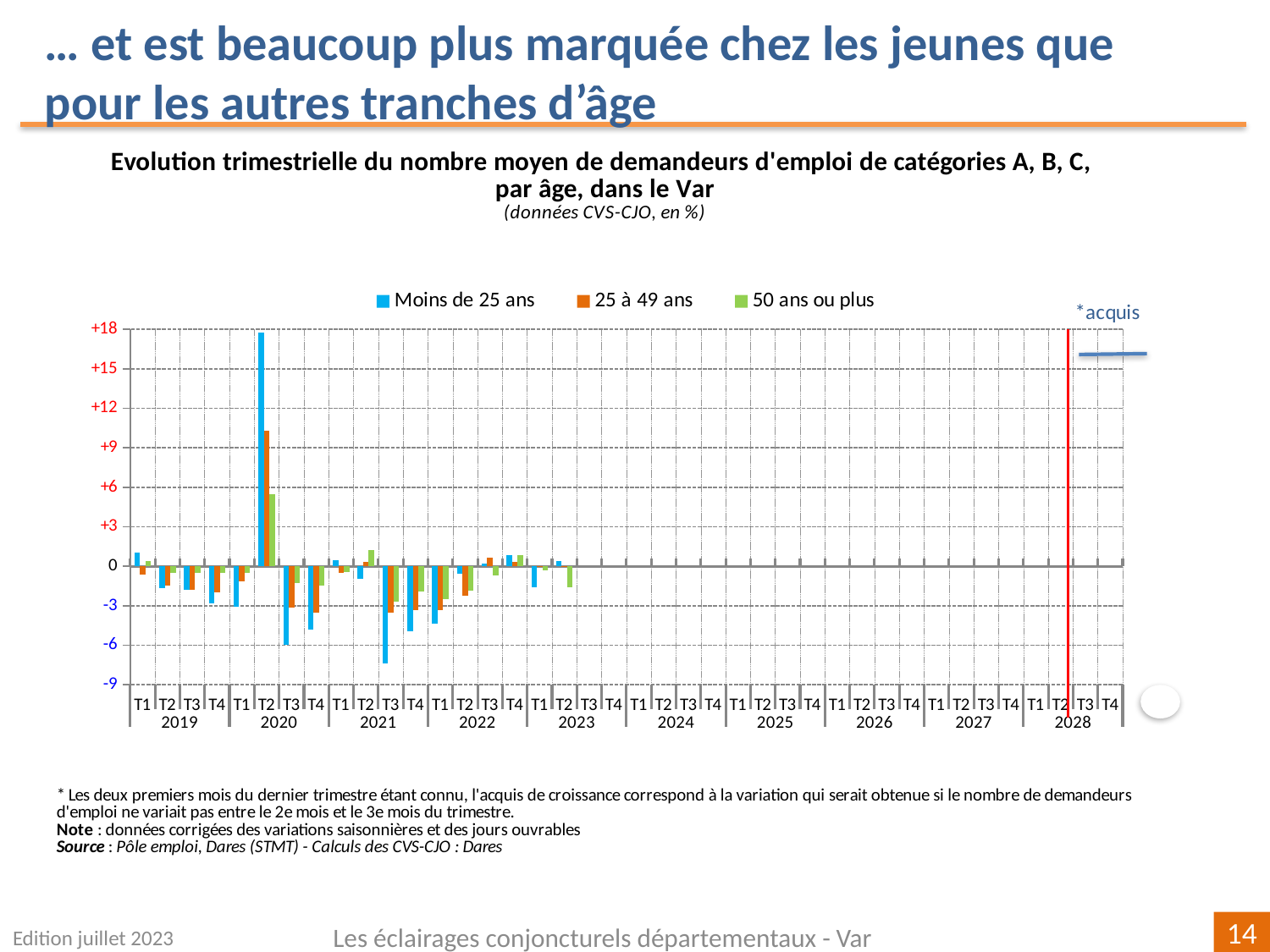
Which series is shown in blue in the legend? Moins de 25 ans Is the value for '50 ans ou plus' in T2 2020 greater or less than +3? greater In which quarter does the 'Moins de 25 ans' series reach its highest value? T2 2020 Is the value for 'Moins de 25 ans' in T3 2021 greater or less than -6? less How many years are labelled along the x axis? 10 What kind of chart is shown on the slide? Bar chart Is the value for '25 à 49 ans' in T2 2020 greater or less than +9? greater How many series does the legend list? 3 In T3 2021, which series has the lowest value? Moins de 25 ans In which quarter does the 'Moins de 25 ans' series reach its lowest value? T3 2021 In T2 2020, which series has the larger value: 'Moins de 25 ans' or '25 à 49 ans'? Moins de 25 ans